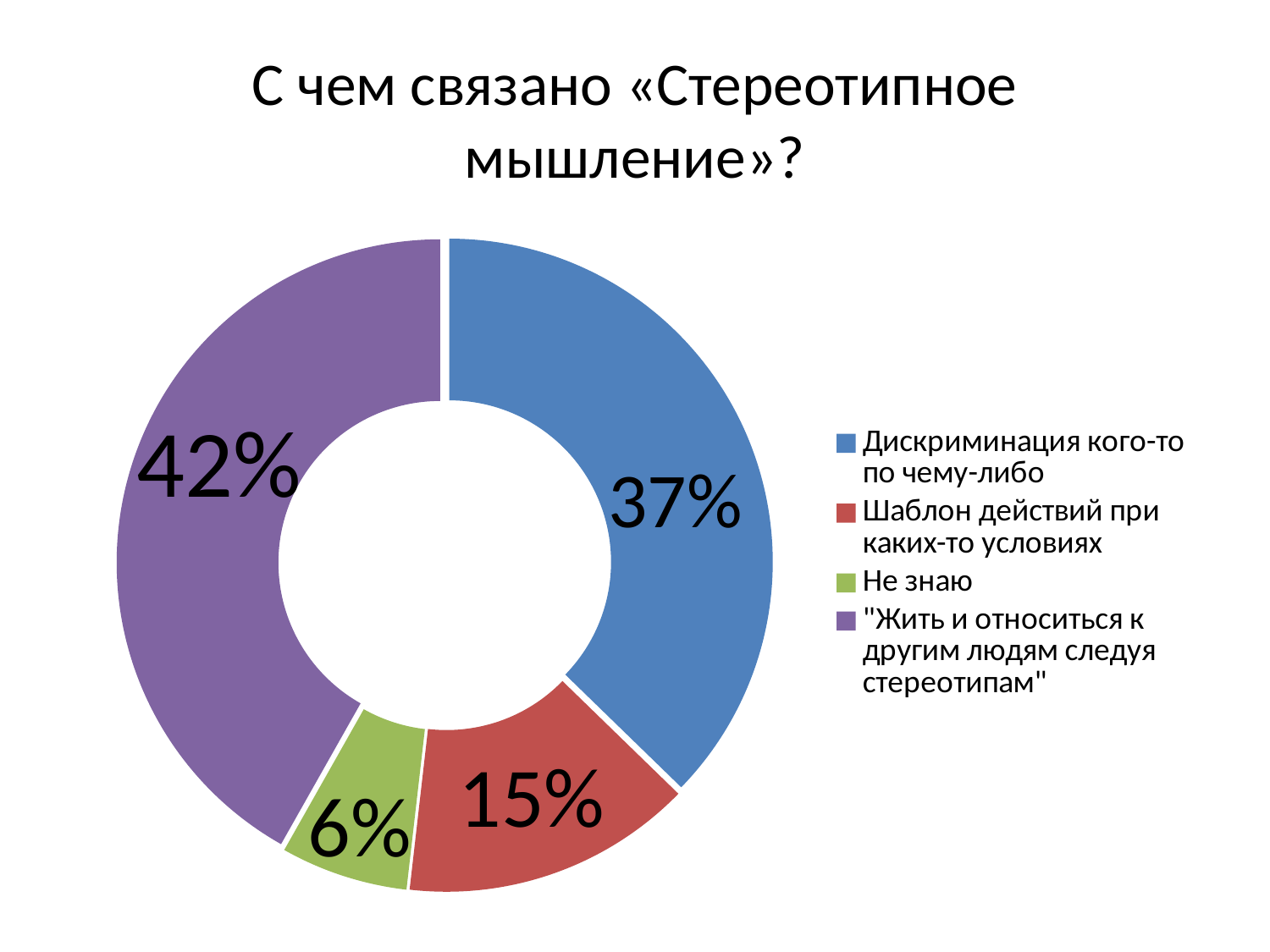
What colour is the slice for "Не знаю"? Green What is the value shown for "Шаблон действий при каких-то условиях"? 15% What is the value shown for "Жить и относиться к другим людям следуя стереотипам"? 42% Which category has the largest share of the chart? "Жить и относиться к другим людям следуя стереотипам" How many categories are shown in the chart? 4 What share of the chart does "Дискриминация кого-то по чему-либо" account for? 37% What is the title of the chart? С чем связано «Стереотипное мышление»? Which category has the smallest share of the chart? Не знаю What is the value shown for "Не знаю"? 6% Which is larger: the share for "Шаблон действий при каких-то условиях" or the share for "Не знаю"? Шаблон действий при каких-то условиях What kind of chart is shown on the slide? Doughnut (pie) chart What is the difference between the shares for "Жить и относиться к другим людям следуя стереотипам" and "Дискриминация кого-то по чему-либо"? 5%